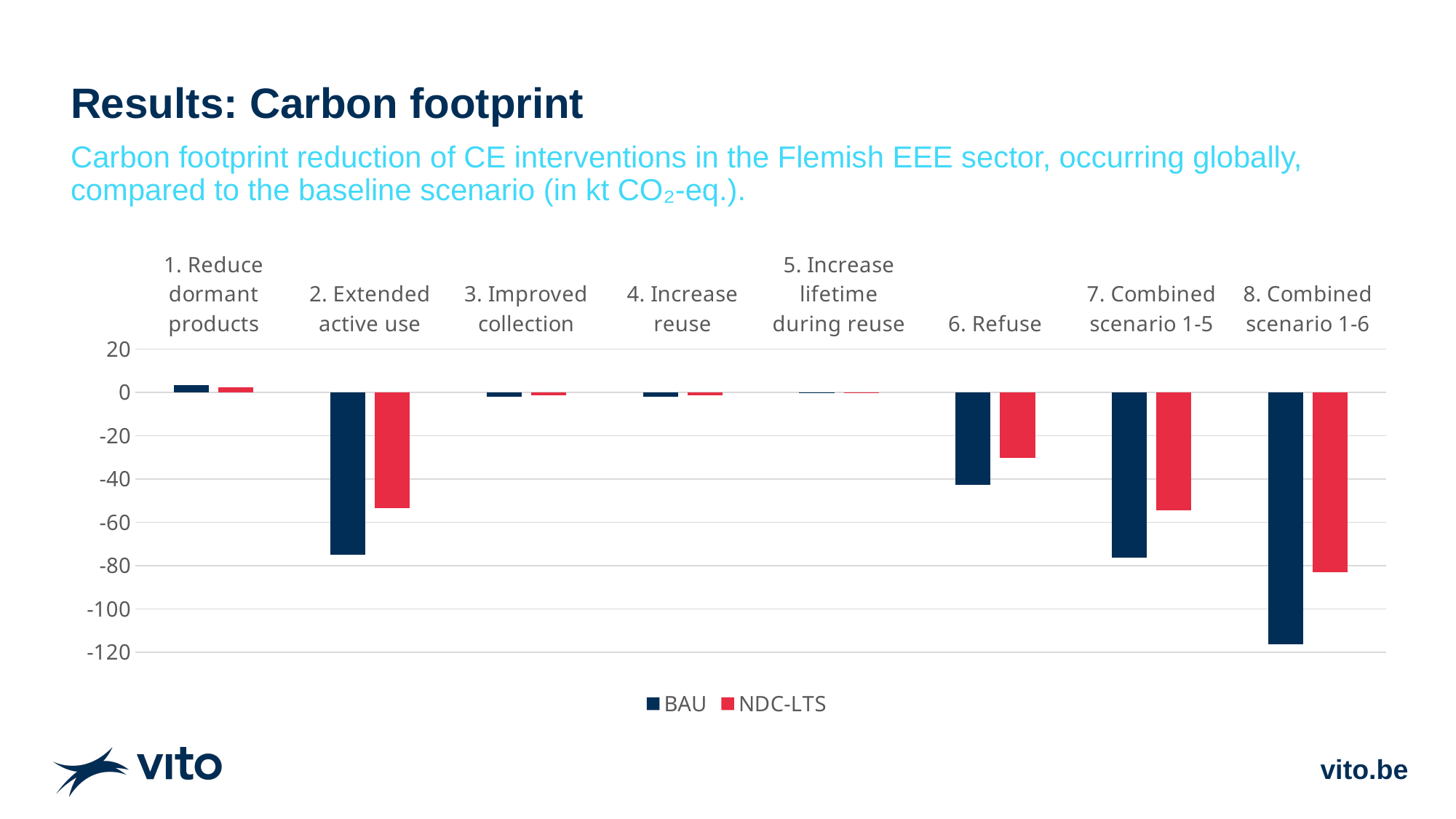
Is the BAU value for 8. Combined scenario 1-6 greater or less than -100? less For 6. Refuse, which series has the larger (less negative) value, BAU or NDC-LTS? NDC-LTS How many series does the legend list? 2 Which category has the lowest (most negative) NDC-LTS value? 8. Combined scenario 1-6 Is the NDC-LTS value for 7. Combined scenario 1-5 greater or less than -40? less Is the NDC-LTS value for 6. Refuse greater or less than -40? greater Which colour represents the NDC-LTS series in the legend? Red How many intervention categories are shown on the x axis? 8 Which category has the highest BAU value? 1. Reduce dormant products What kind of chart is shown on the slide? Bar chart Which category has the lowest (most negative) BAU value? 8. Combined scenario 1-6